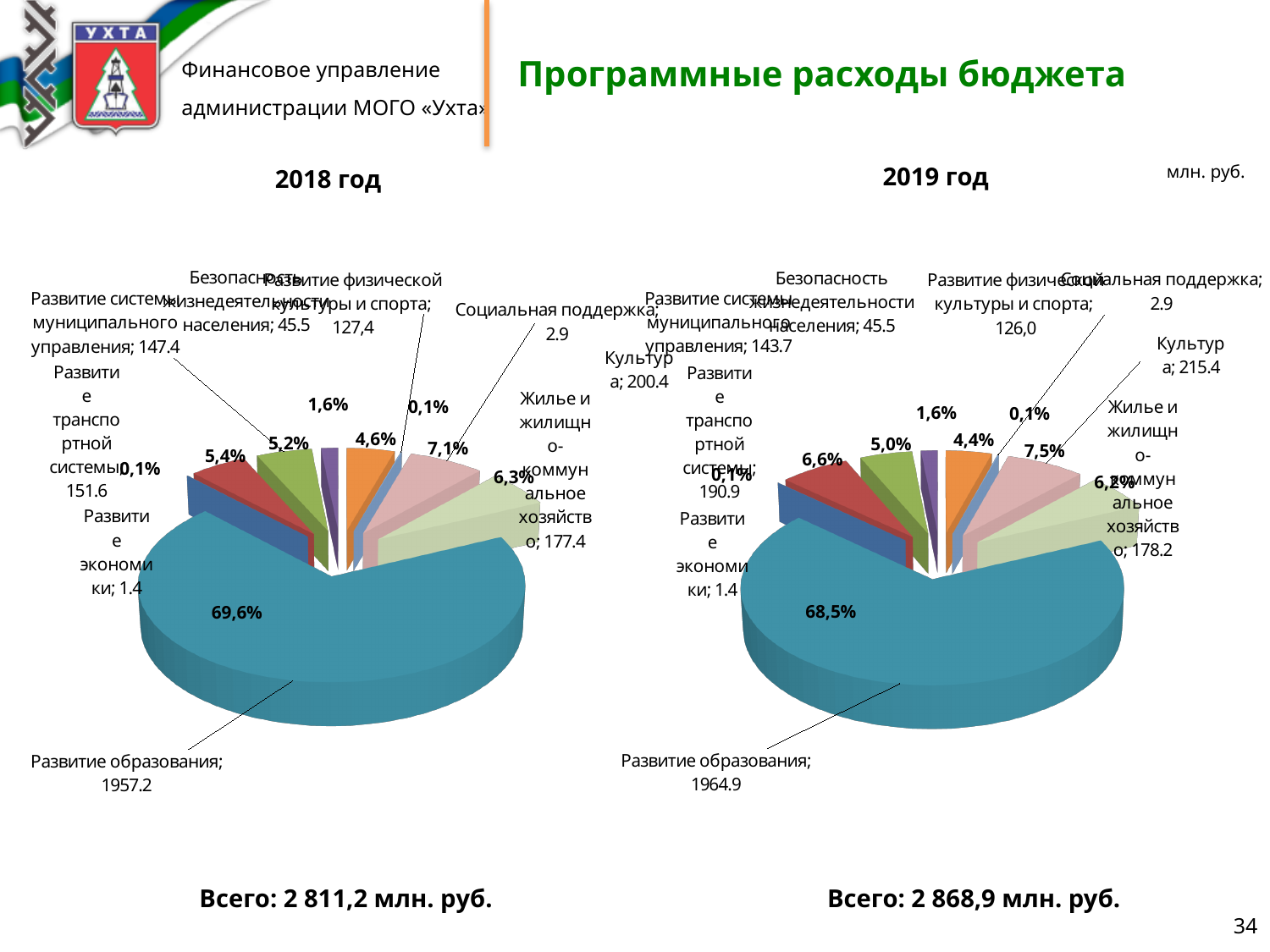
On the 2019 год chart, what is the value for Культура? 215.4 On the 2018 год chart, what share of the pie does Культура take? 7,1% On the 2018 год chart, which is larger: Культура or Жилье и жилищно-коммунальное хозяйство? Культура What total is stated below the 2018 год chart? 2 811,2 млн. руб. On the 2019 год chart, which category has the smallest value? Развитие экономики On the 2018 год chart, which category has the largest value? Развитие образования On the 2019 год chart, what is the difference between Развитие транспортной системы and Развитие системы муниципального управления? 47.2 On the 2019 год chart, what is the value for Развитие физической культуры и спорта? 126,0 How many categories are shown on the 2018 год chart? 9 On the 2019 год chart, what share of the pie does Развитие образования take? 68,5% On the 2018 год chart, what is the value for Развитие образования? 1957.2 What type of chart is used for 2019 год? Pie chart